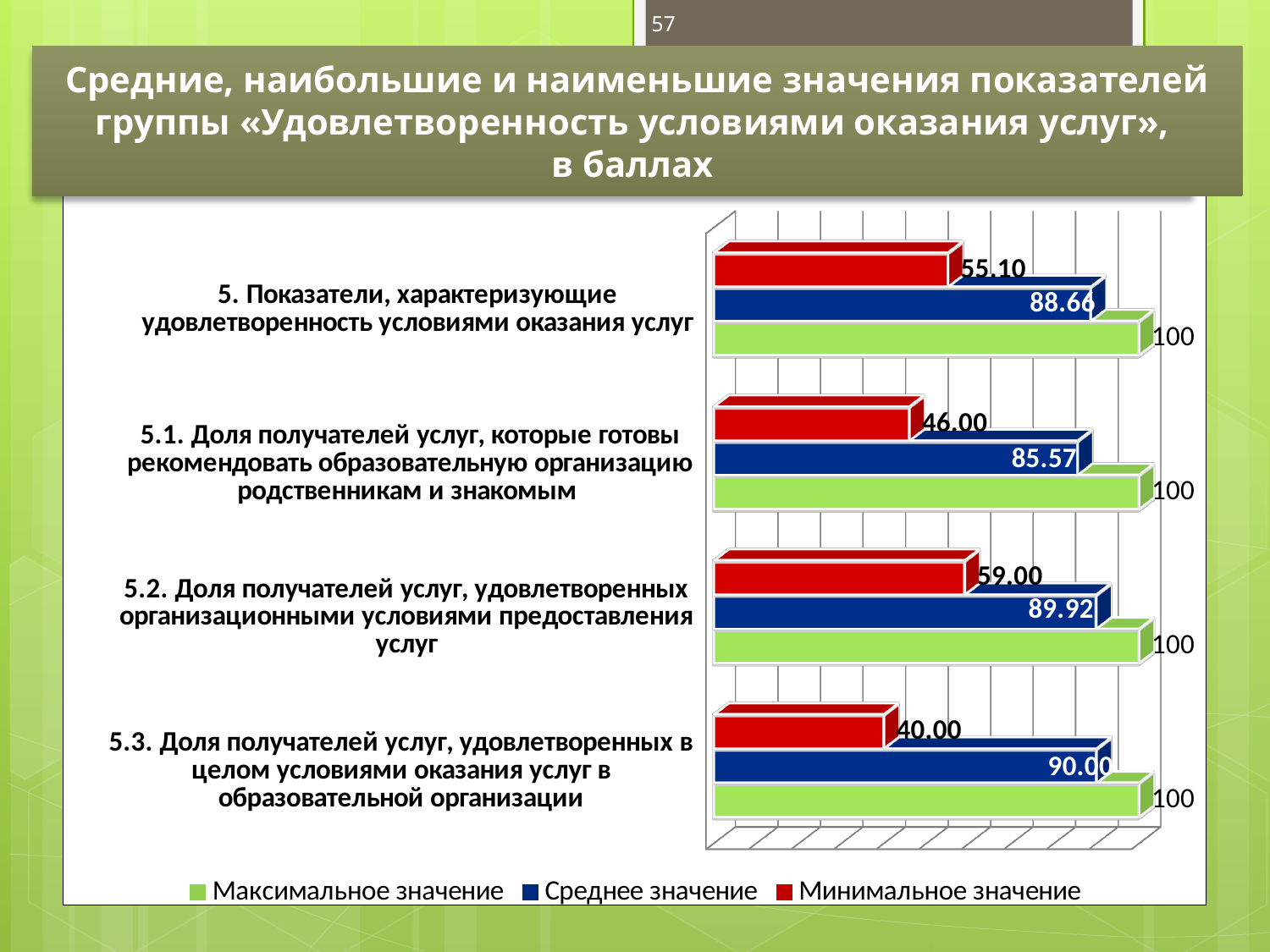
На сколько среднее значение показателя 5.2 больше его минимального значения? 30.92 Сколько рядов данных указано в легенде диаграммы? 3 Какое минимальное значение больше: у показателя 5 или у показателя 5.2? 5.2 Какое минимальное значение показателя 5.1 «Доля получателей услуг, которые готовы рекомендовать образовательную организацию родственникам и знакомым»? 46.00 Каким цветом на диаграмме обозначено «Минимальное значение»? Красным Какое максимальное значение показателя 5.2 «Доля получателей услуг, удовлетворенных организационными условиями предоставления услуг»? 100 Сколько показателей (категорий) представлено на диаграмме? 4 Какое среднее значение показателя 5.3 «Доля получателей услуг, удовлетворенных в целом условиями оказания услуг в образовательной организации»? 90.00 У какого показателя самое высокое среднее значение? 5.3. Доля получателей услуг, удовлетворенных в целом условиями оказания услуг в образовательной организации Какое среднее значение показателя 5 «Показатели, характеризующие удовлетворенность условиями оказания услуг»? 88.66 Какого типа эта диаграмма? Столбчатая (линейчатая) диаграмма У какого показателя самое низкое минимальное значение? 5.3. Доля получателей услуг, удовлетворенных в целом условиями оказания услуг в образовательной организации